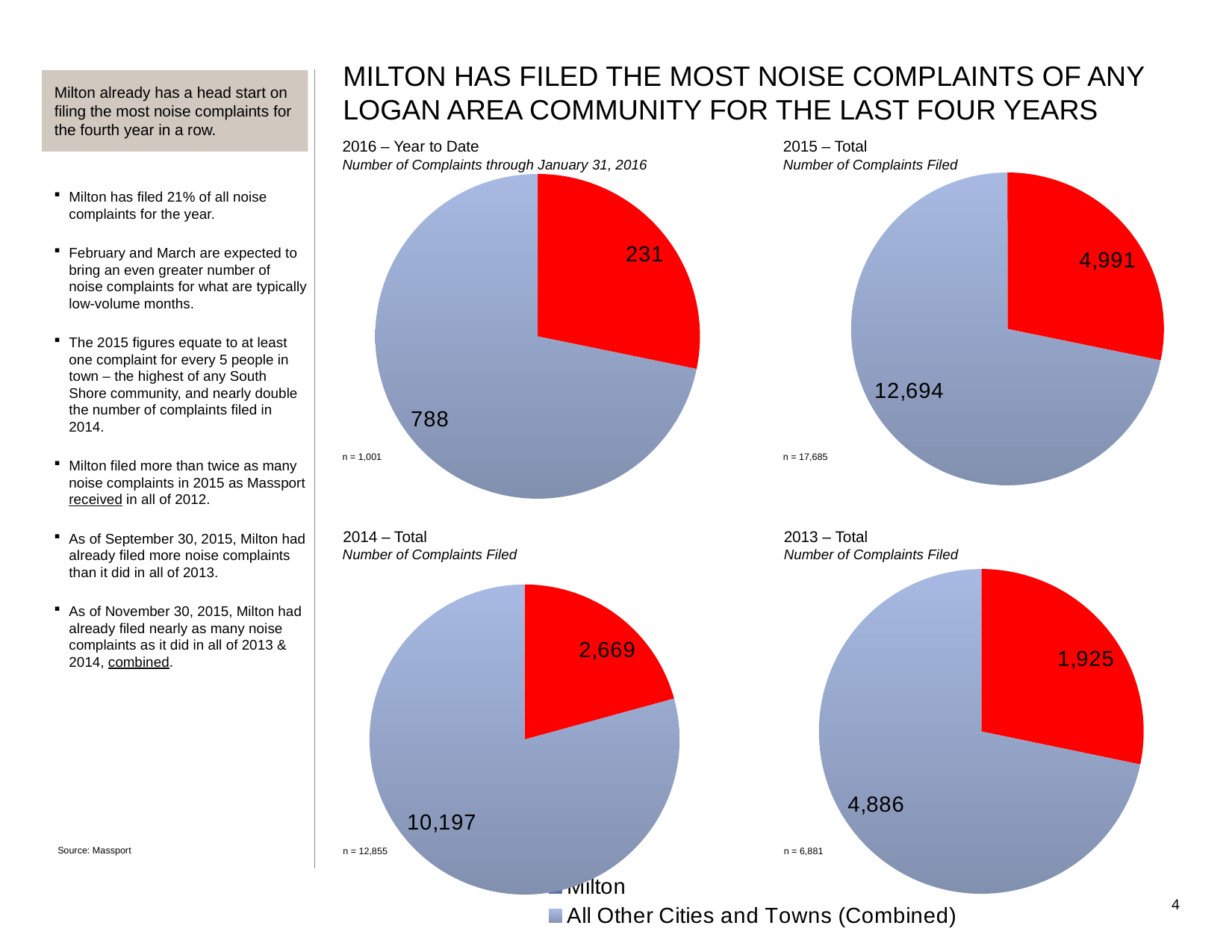
In the 2016 – Year to Date chart, how many complaints were filed by All Other Cities and Towns (Combined)? 788 In the 2015 – Total chart, how many complaints were filed by All Other Cities and Towns (Combined)? 12,694 In the 2015 – Total chart, how many complaints were filed by Milton? 4,991 In the 2014 – Total chart, how many complaints were filed by Milton? 2,669 In the 2014 – Total chart, which slice is larger, Milton or All Other Cities and Towns (Combined)? All Other Cities and Towns (Combined) In the 2016 – Year to Date chart, how many complaints were filed by Milton? 231 In the 2015 – Total chart, what is the total number of complaints filed (n)? 17,685 In the 2015 – Total chart, what share of all complaints was filed by Milton, rounded to the nearest whole percent? 28% In the 2013 – Total chart, how many complaints were filed by All Other Cities and Towns (Combined)? 4,886 What type of chart is used for the 2013 – Total chart? Pie chart In the 2013 – Total chart, what is the difference between the complaints filed by All Other Cities and Towns (Combined) and by Milton? 2,961 How many series does the legend list for the charts on the slide? 2